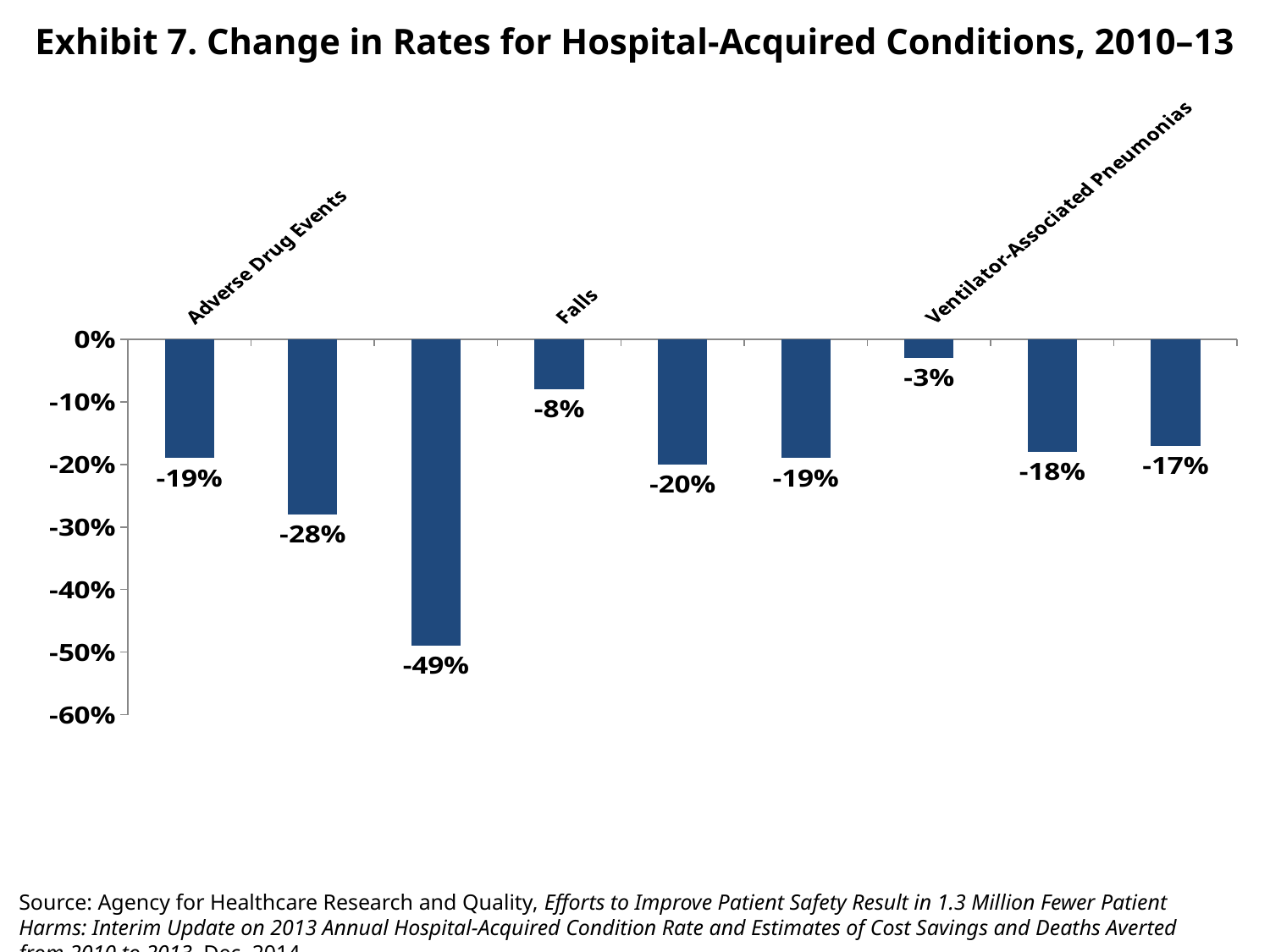
What is the title of the chart? Exhibit 7. Change in Rates for Hospital-Acquired Conditions, 2010–13 What is the difference between the values for Falls and Ventilator-Associated Pneumonias? 5 percentage points What is the value for Falls? -8% What is the lowest value shown on the chart? -49% Is the value for Adverse Drug Events greater or less than -10%? less How many bars are plotted on the chart? 9 What is the difference between the values for Adverse Drug Events and Falls? 11 percentage points What is the value for Adverse Drug Events? -19% Which labeled category has the highest value (smallest decrease)? Ventilator-Associated Pneumonias Which is larger, the value for Falls or the value for Adverse Drug Events? Falls What kind of chart is shown on the slide? Bar chart What is the value for Ventilator-Associated Pneumonias? -3%